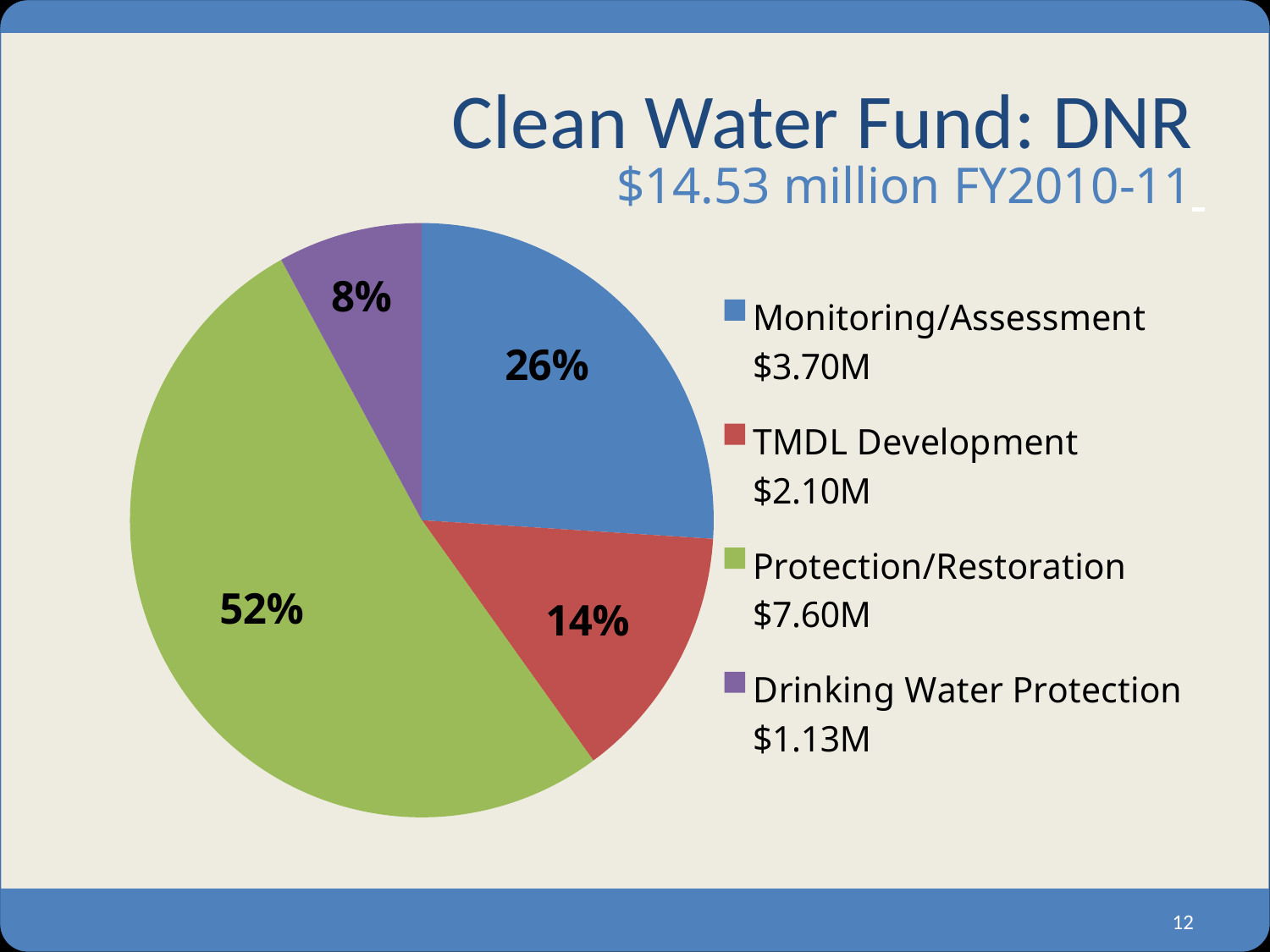
Which category has the largest slice of the pie chart? Protection/Restoration What percentage share does Monitoring/Assessment have in the pie chart? 26% Which category has the smallest slice of the pie chart? Drinking Water Protection Which slice is larger, TMDL Development or Drinking Water Protection? TMDL Development What colour is the Protection/Restoration slice in the pie chart? green What type of chart is shown on the slide? pie chart What percentage share does TMDL Development have in the pie chart? 14% What percentage share does Protection/Restoration have in the pie chart? 52% What is the difference in percentage points between the Protection/Restoration and Monitoring/Assessment slices? 26 How many categories does the pie chart show? 4 What dollar amount does the legend give for TMDL Development? $2.10M